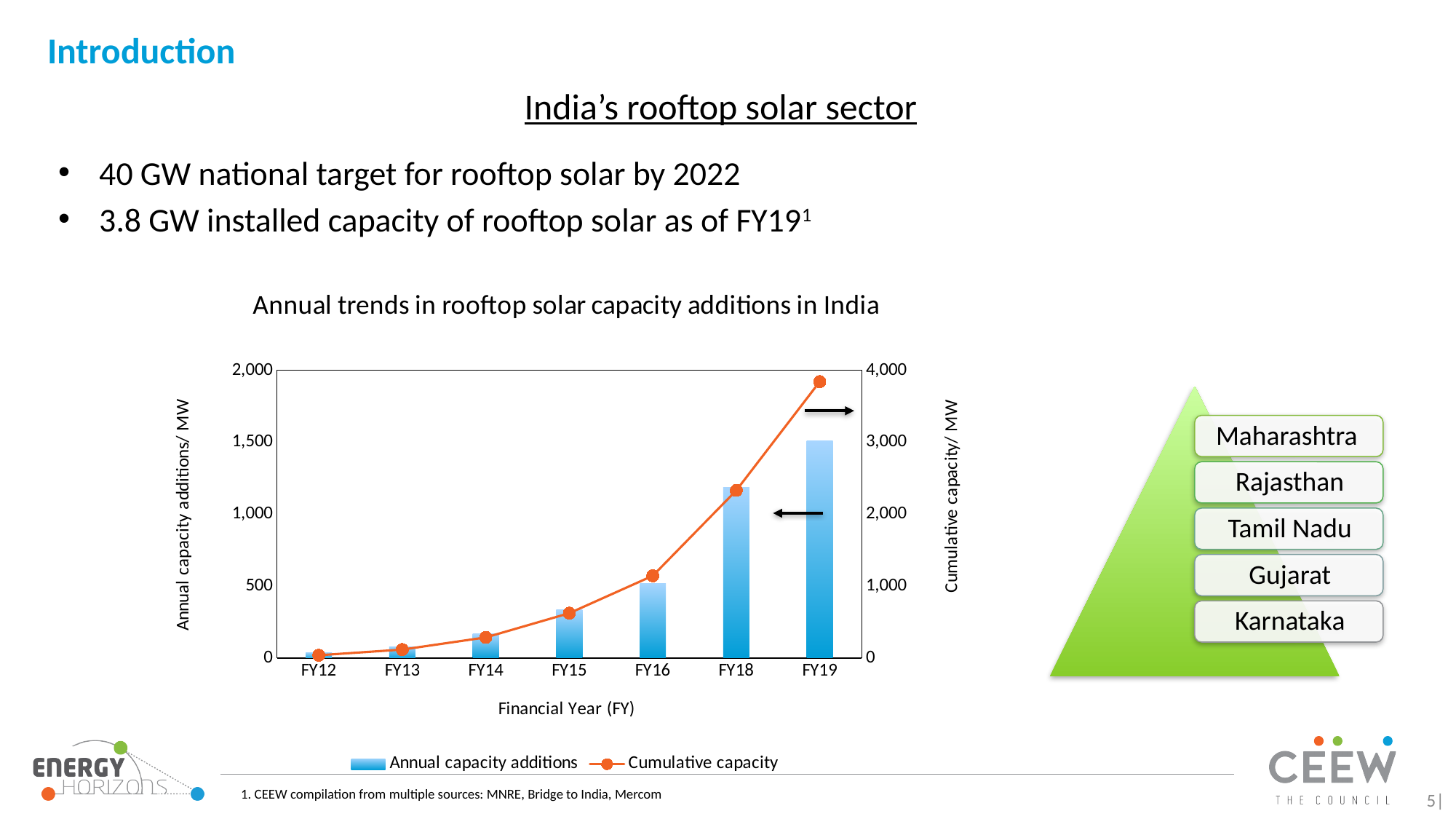
Is the annual capacity additions value for FY18 greater or less than 1,000 MW? greater How many financial years are shown on the x axis of the chart? 7 Do the cumulative capacity values rise or fall from FY12 to FY19? Rise Which financial year has the highest annual capacity additions bar? FY19 What is the title of the chart? Annual trends in rooftop solar capacity additions in India Is the cumulative capacity value for FY15 greater or less than 1,000 MW? less How many series does the chart legend list? 2 Is the annual capacity additions value for FY15 greater or less than 500 MW? less Which financial year has the lowest annual capacity additions bar? FY12 Which has the larger annual capacity additions, FY16 or FY18? FY18 What kind of chart is shown on the slide? A combined bar and line chart